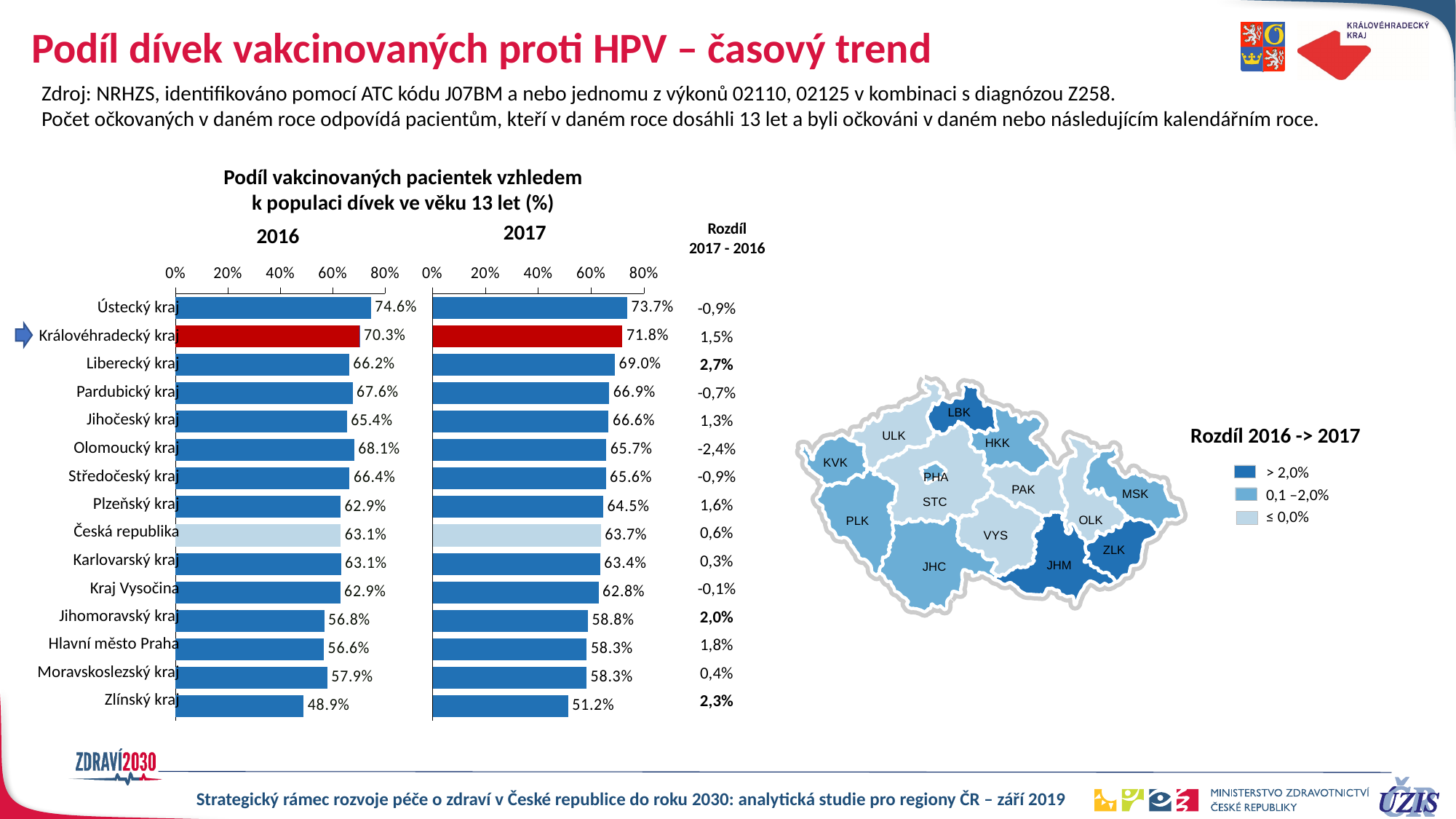
In the 2016 chart, which region has the highest value? Ústecký kraj In the 2017 chart, is the value for Jihomoravský kraj greater or less than 60%? less In the 2016 chart, what is the value for Královéhradecký kraj? 70.3% In the 2016 chart, which is larger: the value for Olomoucký kraj or Pardubický kraj? Olomoucký kraj In the 2017 chart, what is the value for Česká republika? 63.7% In the 2016 chart, what is the value for Zlínský kraj? 48.9% In the 2017 chart, what is the value for Liberecký kraj? 69.0% In the 2016 chart, which bar is highlighted in red? Královéhradecký kraj What kind of chart is used to show the 2016 and 2017 values? bar chart What is the difference between the 2017 and 2016 values for Zlínský kraj? 2.3% In the 2017 chart, which region has the lowest value? Zlínský kraj How many categories (bars) are shown in the 2016 chart? 15